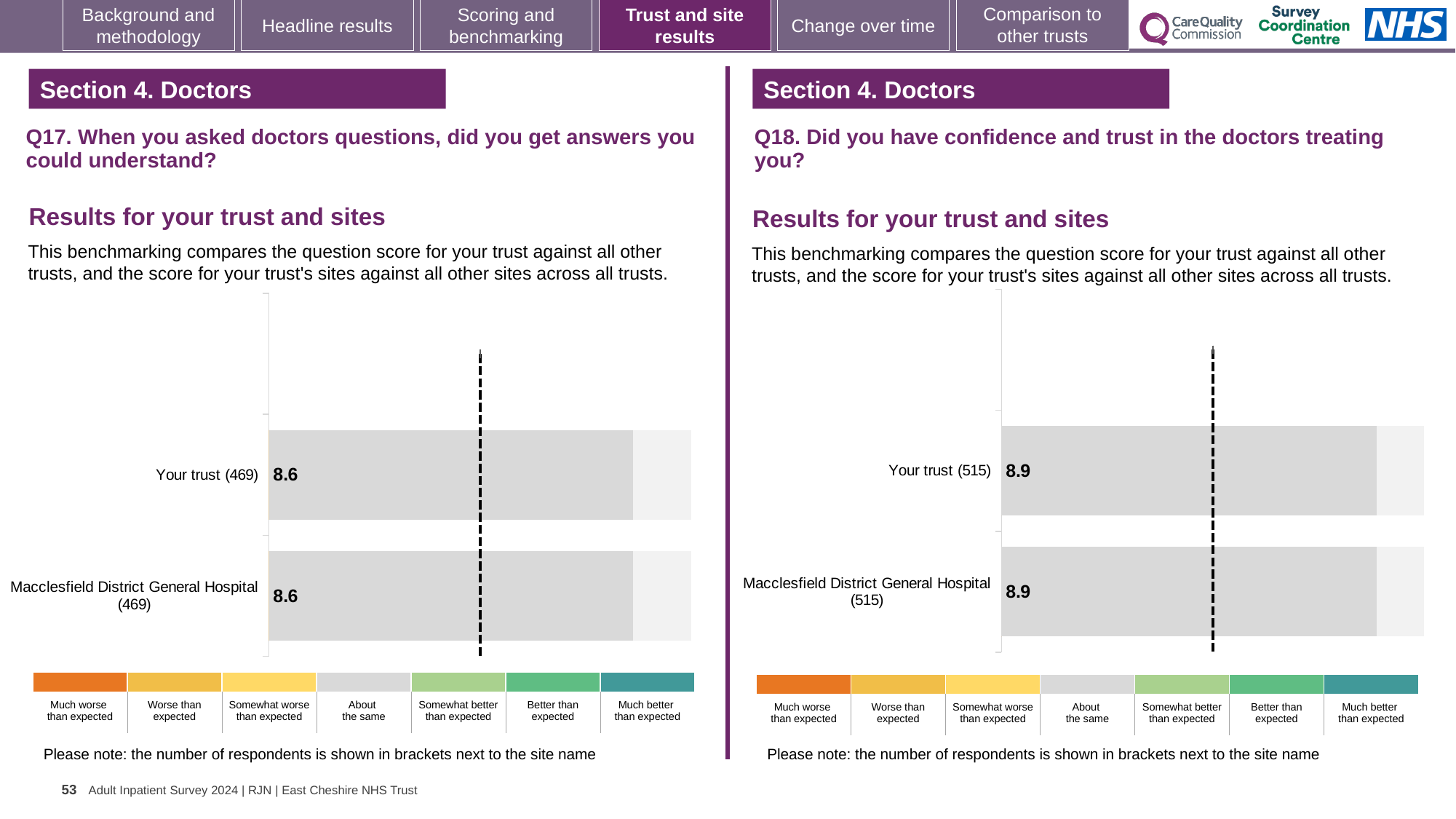
In the Q18 chart on the right, how many respondents are shown in brackets next to Macclesfield District General Hospital? 515 In the Q17 chart on the left, how many respondents are shown in brackets next to Your trust? 469 In the Q18 chart on the right, what is the score for Your trust? 8.9 In the Q18 chart on the right, what is the score for Macclesfield District General Hospital? 8.9 Which is larger: the Your trust score in the Q17 chart or the Your trust score in the Q18 chart? Q18 chart In the Q17 chart on the left, what is the score for Your trust? 8.6 How many bars are plotted in the Q17 chart on the left? 2 How many bars are plotted in the Q18 chart on the right? 2 In the Q17 chart on the left, what is the score for Macclesfield District General Hospital? 8.6 What kind of chart is used for the Q17 results on the left? Bar chart In the Q18 chart on the right, is the score for Your trust greater or less than 8.6? greater What is the difference between the Your trust score in the Q18 chart and the Your trust score in the Q17 chart? 0.3